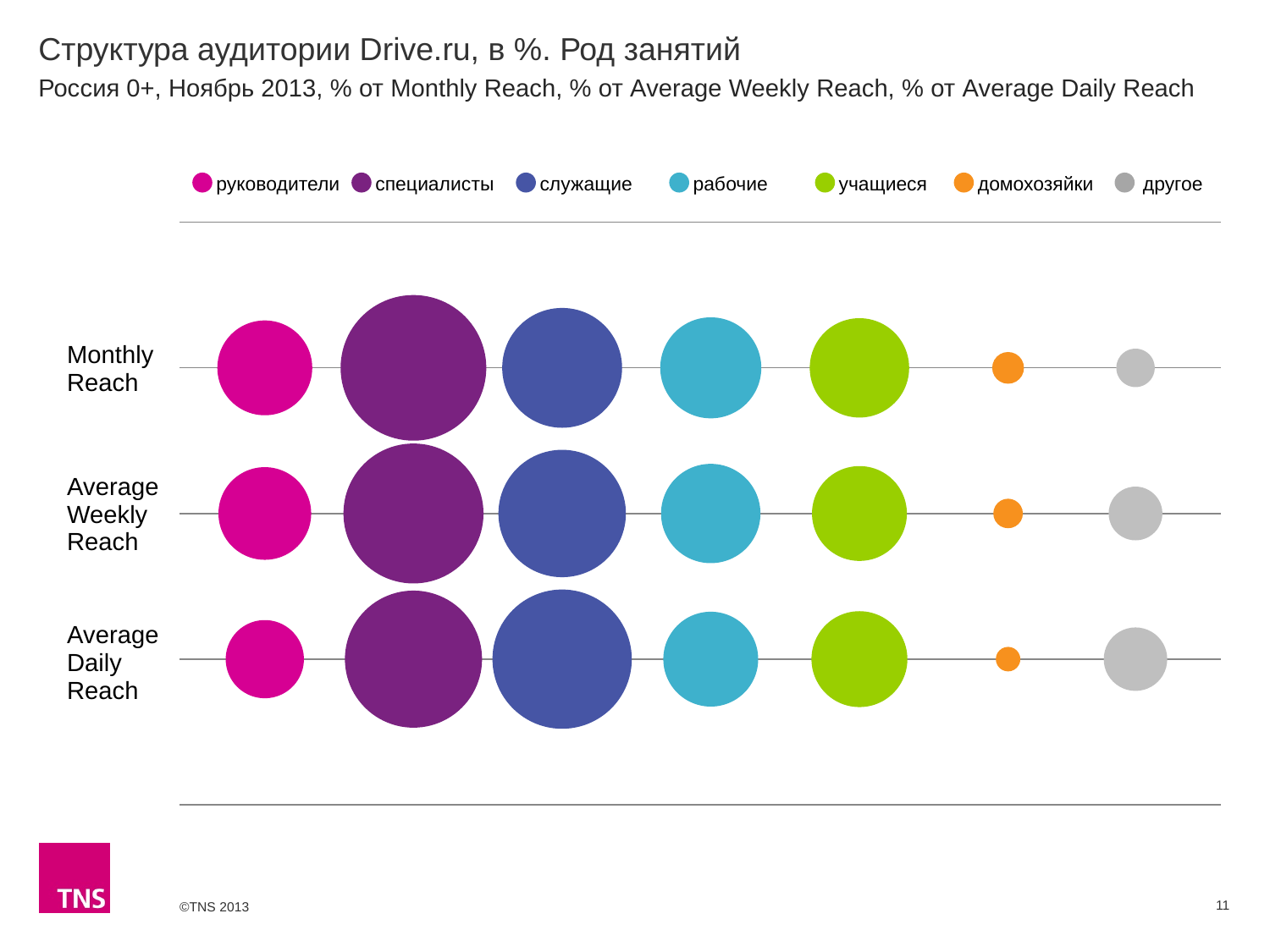
How many series does the legend list? 7 What is the first legend entry listed on the chart? руководители Which occupation group has the largest bubble in the Monthly Reach row? специалисты Which legend entry is shown in orange? домохозяйки Which occupation group has the smallest bubble in the Average Weekly Reach row? домохозяйки What kind of chart is shown on the slide? bubble chart Which occupation group has the smallest bubble in the Monthly Reach row? домохозяйки In the Average Daily Reach row, which bubble is larger: служащие or рабочие? служащие In the Monthly Reach row, which bubble is larger: специалисты or учащиеся? специалисты In the Average Daily Reach row, which bubble is larger: другое or домохозяйки? другое How many reach categories (rows) are plotted on the chart? 3